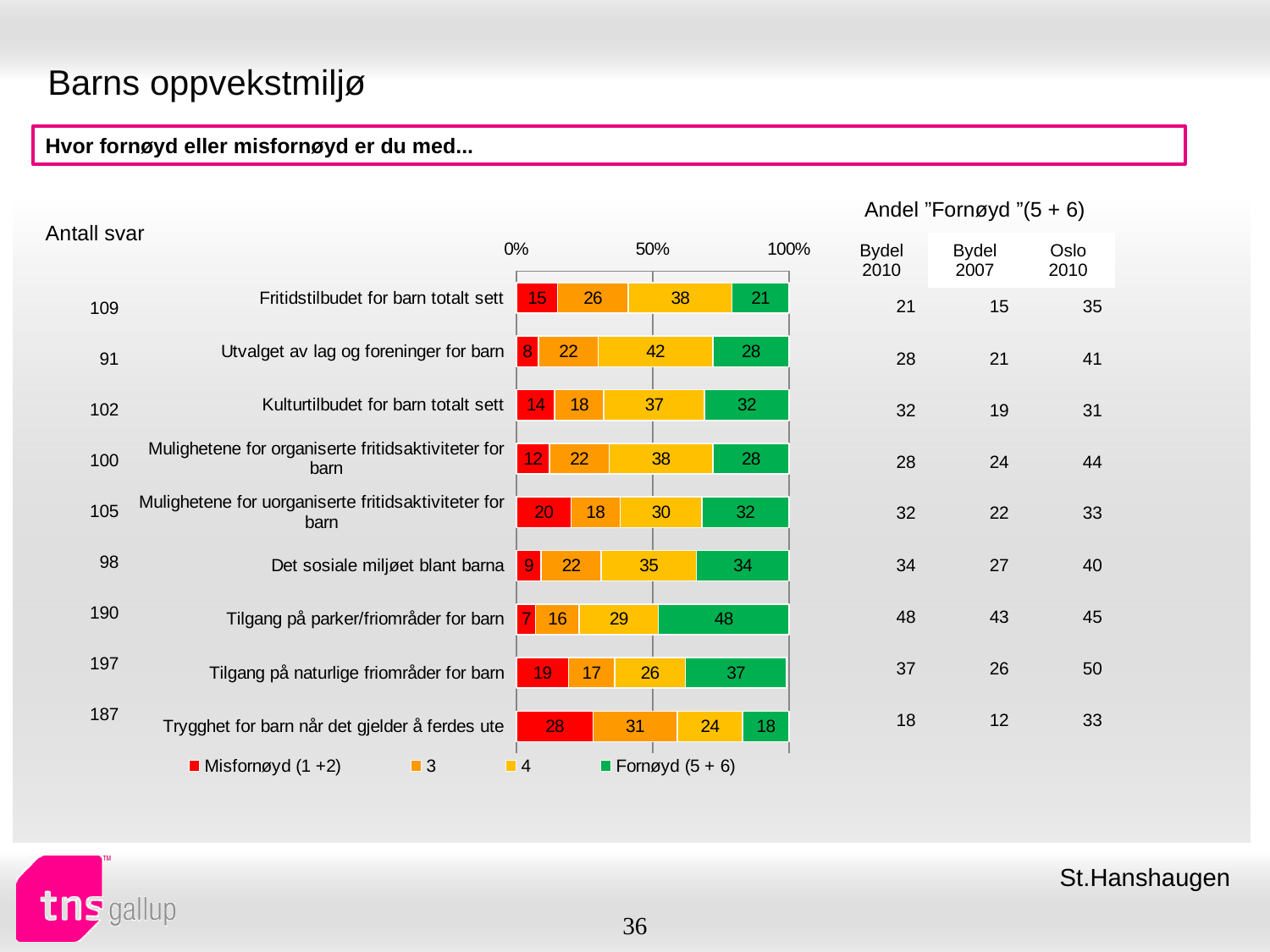
What is the 'Misfornøyd (1 +2)' value for 'Trygghet for barn når det gjelder å ferdes ute'? 28 Which category has the lowest 'Misfornøyd (1 +2)' value? Tilgang på parker/friområder for barn How many series does the chart legend list? 4 Which is larger: the 'Misfornøyd (1 +2)' value for 'Mulighetene for uorganiserte fritidsaktiviteter for barn' or for 'Det sosiale miljøet blant barna'? Mulighetene for uorganiserte fritidsaktiviteter for barn What is the value of series '4' for 'Utvalget av lag og foreninger for barn'? 42 Which category has the lowest 'Fornøyd (5 + 6)' value? Trygghet for barn når det gjelder å ferdes ute What kind of chart is shown on the slide? Stacked bar chart What is the total of the stacked bar for 'Fritidstilbudet for barn totalt sett'? 100 What is the difference between the 'Fornøyd (5 + 6)' values for 'Tilgang på parker/friområder for barn' and 'Trygghet for barn når det gjelder å ferdes ute'? 30 What is the 'Fornøyd (5 + 6)' value for 'Tilgang på parker/friområder for barn'? 48 Which category has the highest 'Fornøyd (5 + 6)' value? Tilgang på parker/friområder for barn How many categories are plotted in the chart? 9